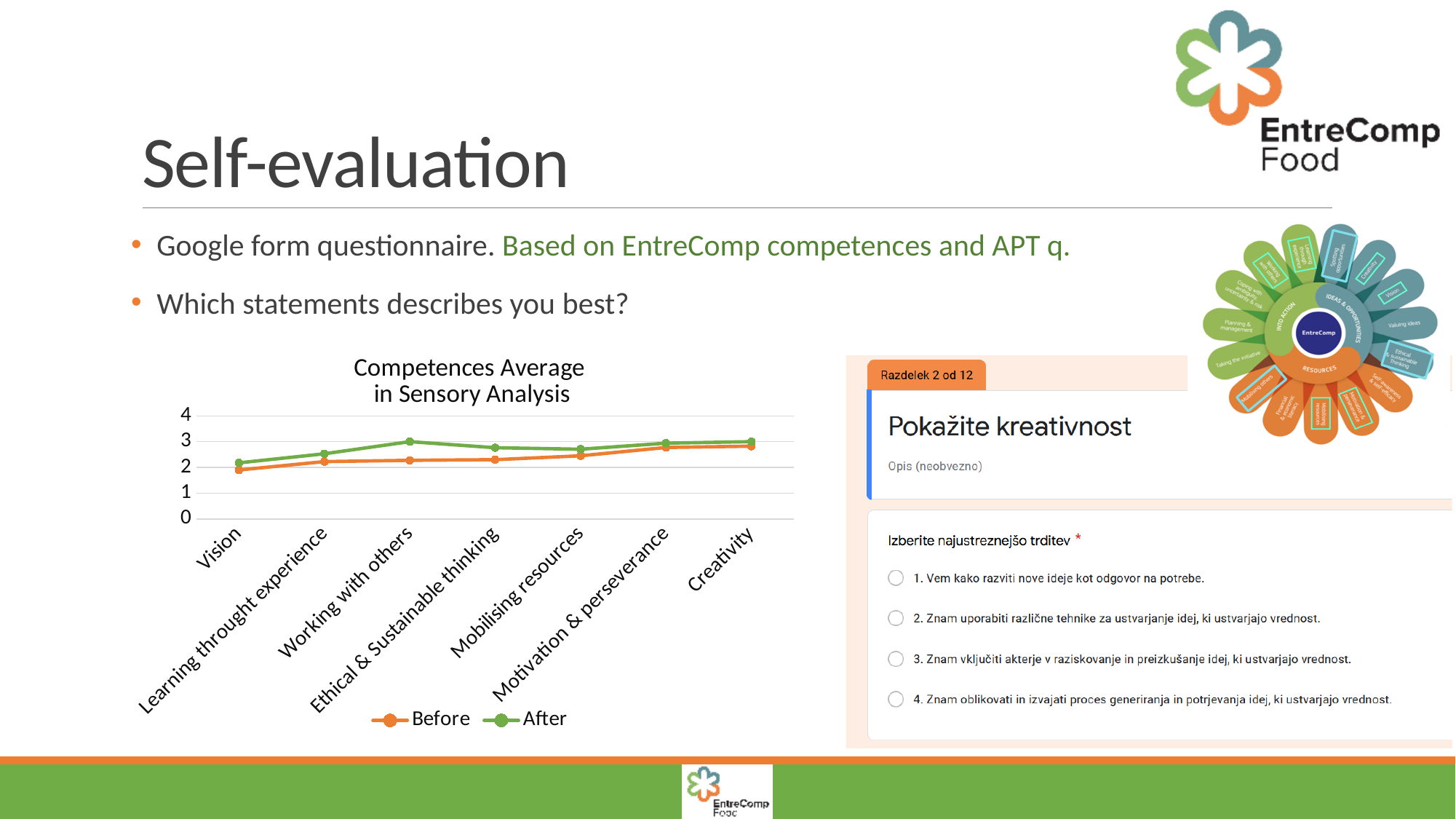
Is the "Before" value for Vision greater or less than 3? less For Vision, which series has the larger value, Before or After? After For Working with others, which series has the larger value, Before or After? After What kind of chart is "Competences Average in Sensory Analysis"? line chart Which colour is used for the "After" series in the chart? green What is the title of the chart on the slide? Competences Average in Sensory Analysis How many competence categories are plotted along the x axis of the chart? 7 Is the "After" value for Working with others greater or less than 2? greater Does the "Before" line generally rise or fall from Vision to Creativity? rise In the "Before" series, which category has the lowest value? Vision Is the "Before" value for Creativity greater or less than 2? greater How many series does the legend of the "Competences Average in Sensory Analysis" chart list? 2